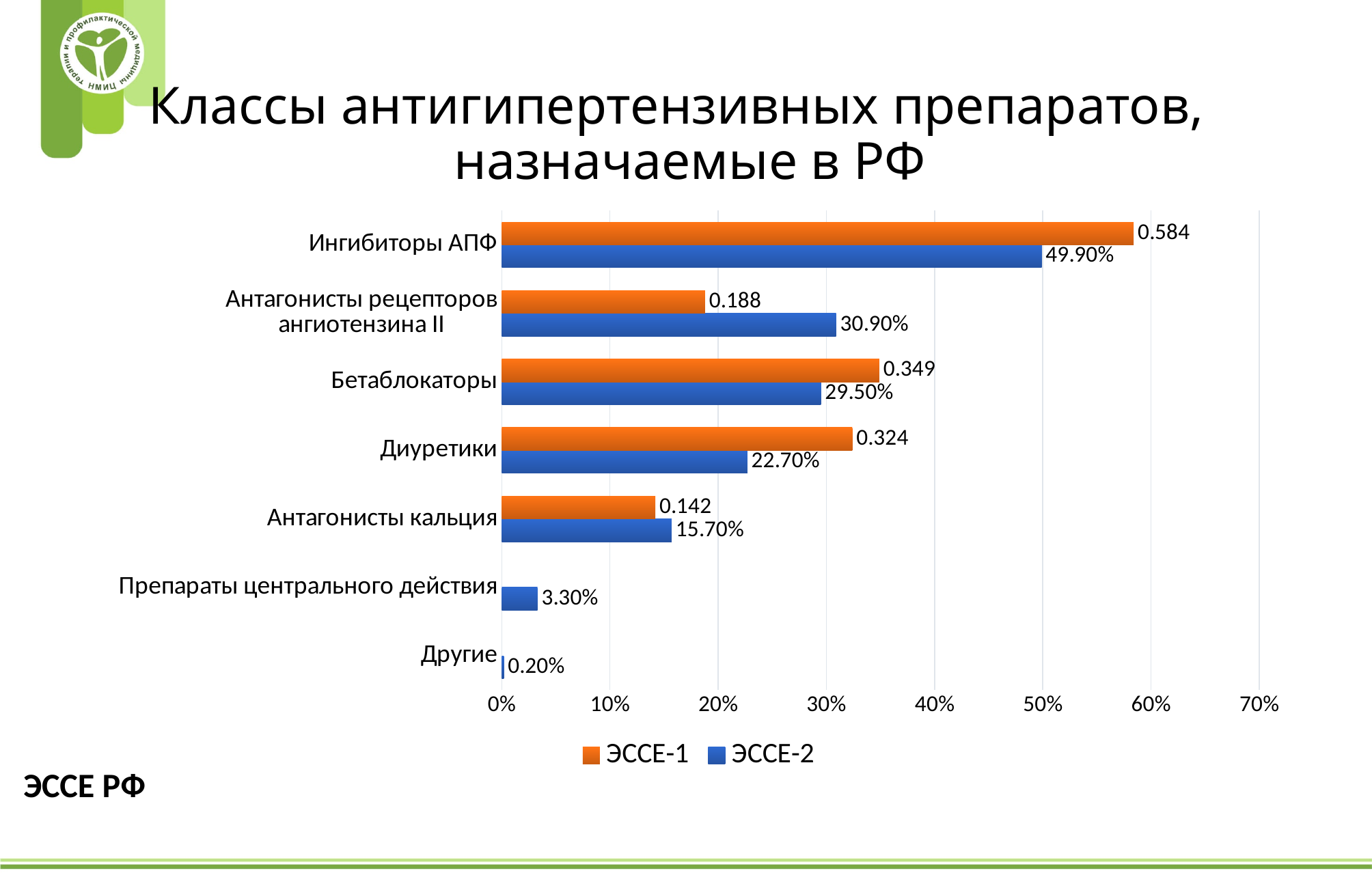
How many series does the legend list? 2 What is the ЭССЕ-1 value for Антагонисты кальция? 0.142 What is the ЭССЕ-2 value for Препараты центрального действия? 3.30% What type of chart is shown on the slide? Bar chart What is the difference between the ЭССЕ-2 values for Ингибиторы АПФ and Антагонисты рецепторов ангиотензина II? 19.00% Which category has the lowest ЭССЕ-2 value? Другие Which colour represents the ЭССЕ-1 series? Orange How many drug classes (categories) are shown on the chart? 7 Which category has the highest ЭССЕ-2 value? Ингибиторы АПФ Which is larger for ЭССЕ-1: Диуретики or Антагонисты рецепторов ангиотензина II? Диуретики What is the ЭССЕ-1 value for Бетаблокаторы? 0.349 What is the ЭССЕ-2 value for Ингибиторы АПФ? 49.90%